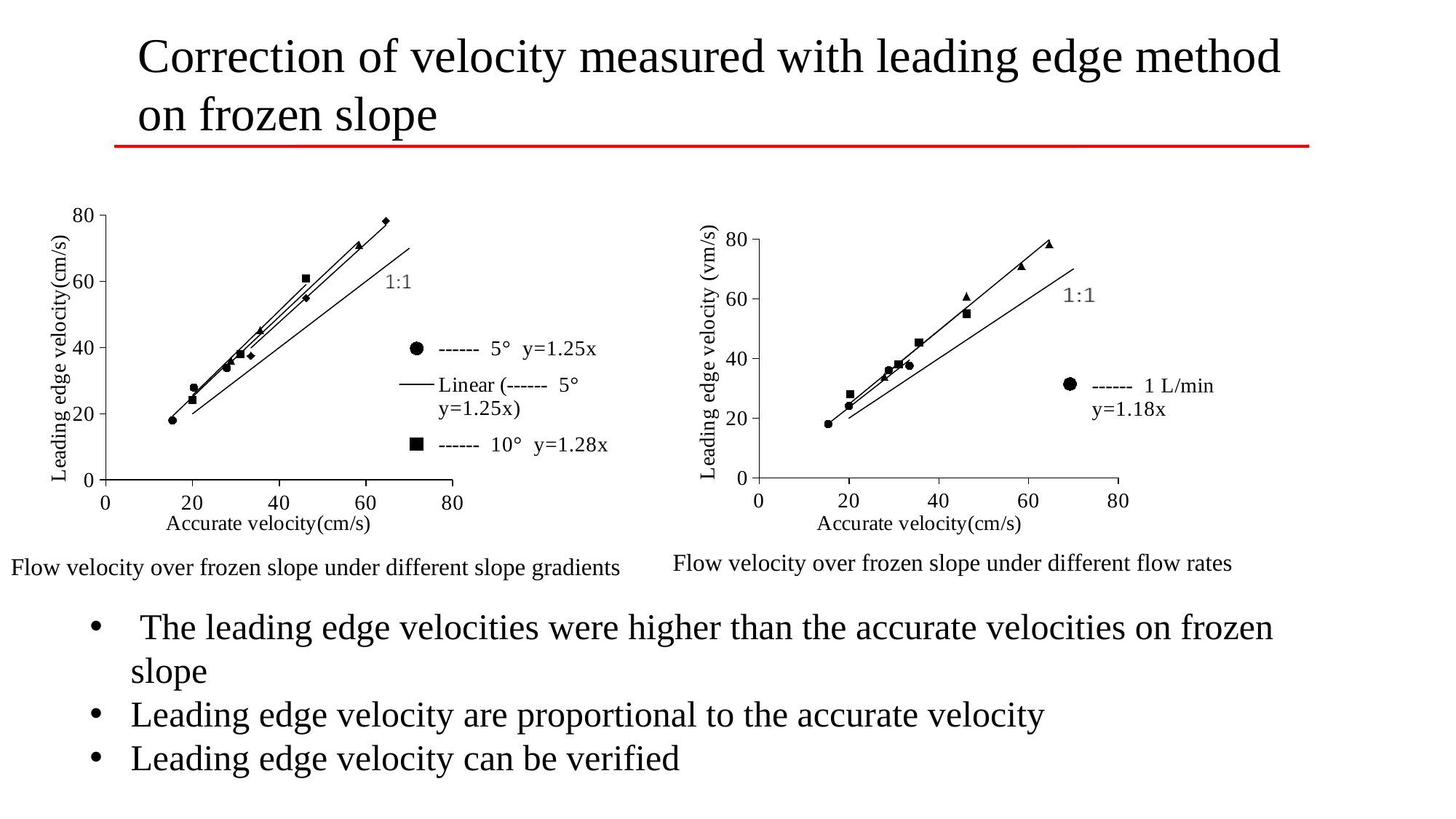
In the left chart, what fitted equation is given in the legend for the 10° series? y=1.28x In the left chart, what is the label of the x axis? Accurate velocity(cm/s) In the right chart, what fitted equation is given in the legend for the 1 L/min series? y=1.18x In the right chart, is the lowest plotted leading edge velocity greater or less than 20? less In the left chart, what fitted equation is given in the legend for the 5° series? y=1.25x What kind of chart is the left chart, 'Flow velocity over frozen slope under different slope gradients'? scatter chart In the left chart, do the leading edge velocity values rise or fall as accurate velocity increases along the x axis? rise In the right chart, do the leading edge velocity values rise or fall as accurate velocity increases along the x axis? rise What is the maximum value shown on the y axis of the left chart? 80 What kind of chart is the right chart, 'Flow velocity over frozen slope under different flow rates'? scatter chart In the right chart, what is the label of the y axis? Leading edge velocity (vm/s) In the left chart, is the highest plotted leading edge velocity greater or less than 60? greater